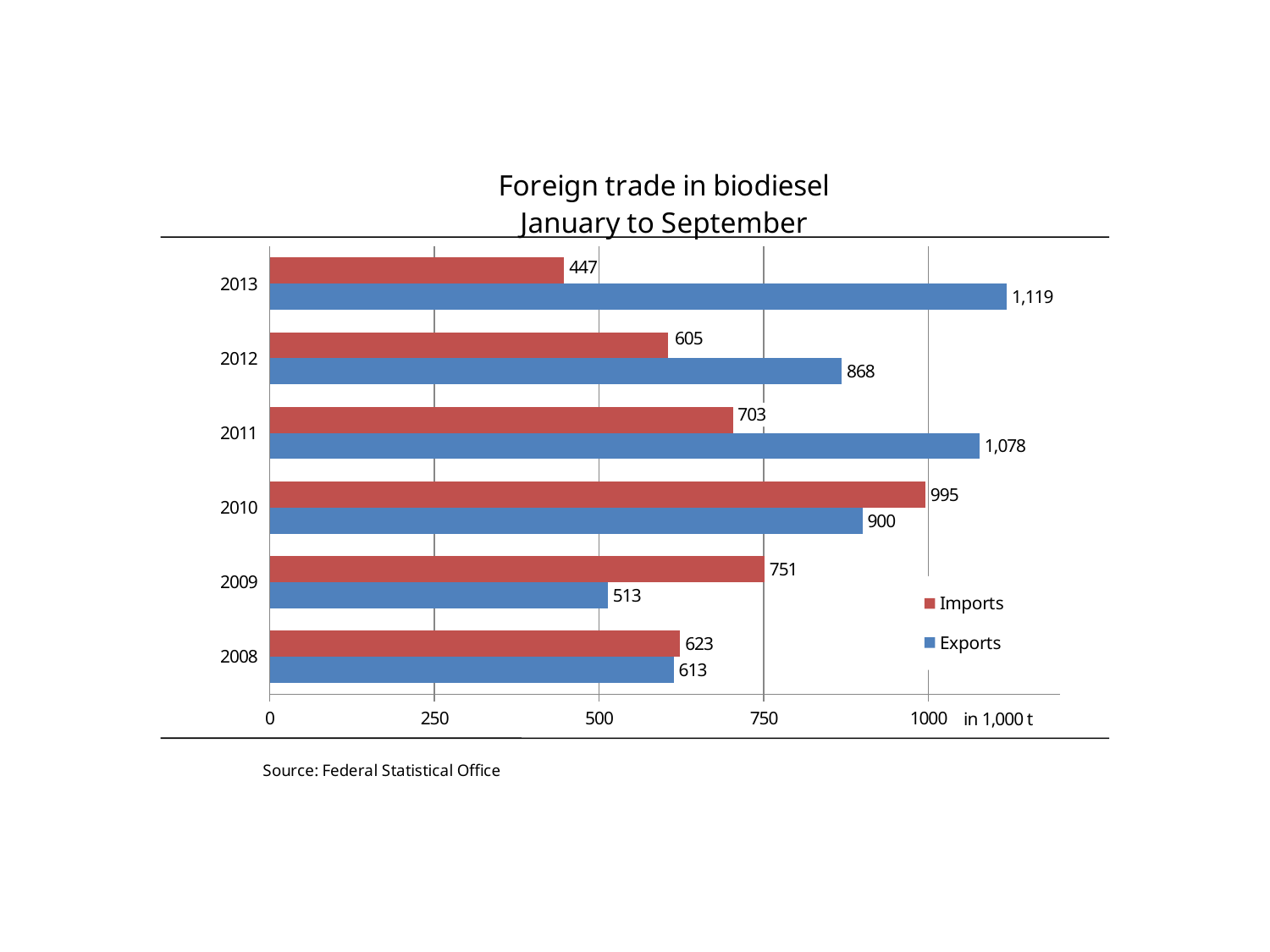
How many years are shown on the chart? 6 What is the difference between Exports and Imports in 2013? 672 Is the value of Exports for 2012 greater or less than 750? greater What is the value of Imports for 2010? 995 What is the value of Exports for 2009? 513 How many series does the legend list? 2 Which year has the lowest Imports value? 2013 Which year has the highest Exports value? 2013 Which is larger in 2009, Imports or Exports? Imports What is the difference between Imports in 2010 and Imports in 2011? 292 What kind of chart is shown on the slide? bar chart What is the value of Exports for 2013? 1,119